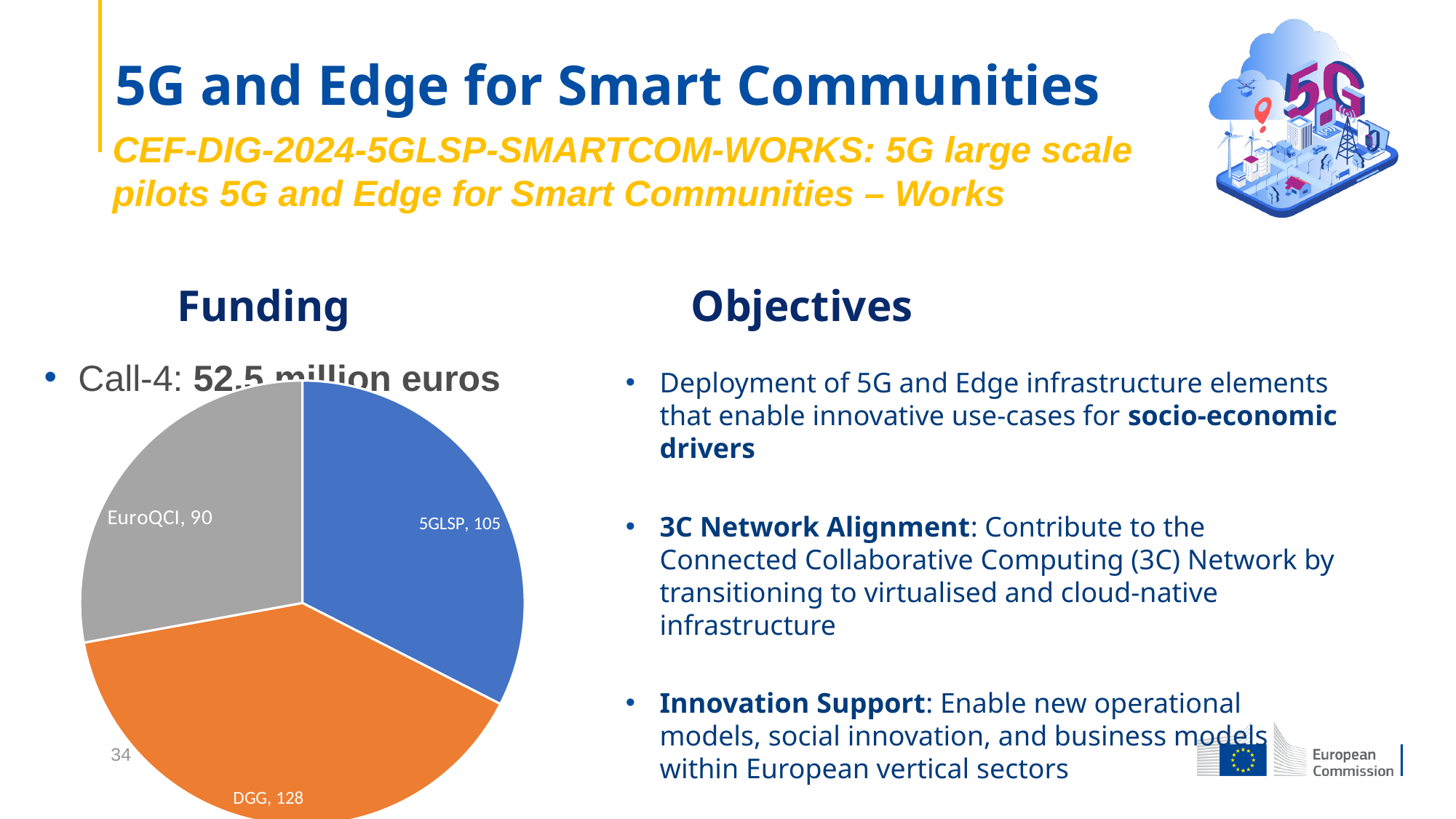
What is the total of all slices in the pie chart? 323 Which slice of the pie chart has the smallest value? EuroQCI What type of chart is shown on the slide? pie chart What is the value for 5GLSP in the pie chart? 105 What is the value for EuroQCI in the pie chart? 90 What colour is the DGG slice in the pie chart? orange What is the difference between the 5GLSP and EuroQCI values in the pie chart? 15 How many slices does the pie chart have? 3 What is the value for DGG in the pie chart? 128 Which is larger in the pie chart, DGG or EuroQCI? DGG Which slice of the pie chart has the largest value? DGG What is the difference between the DGG and 5GLSP values in the pie chart? 23